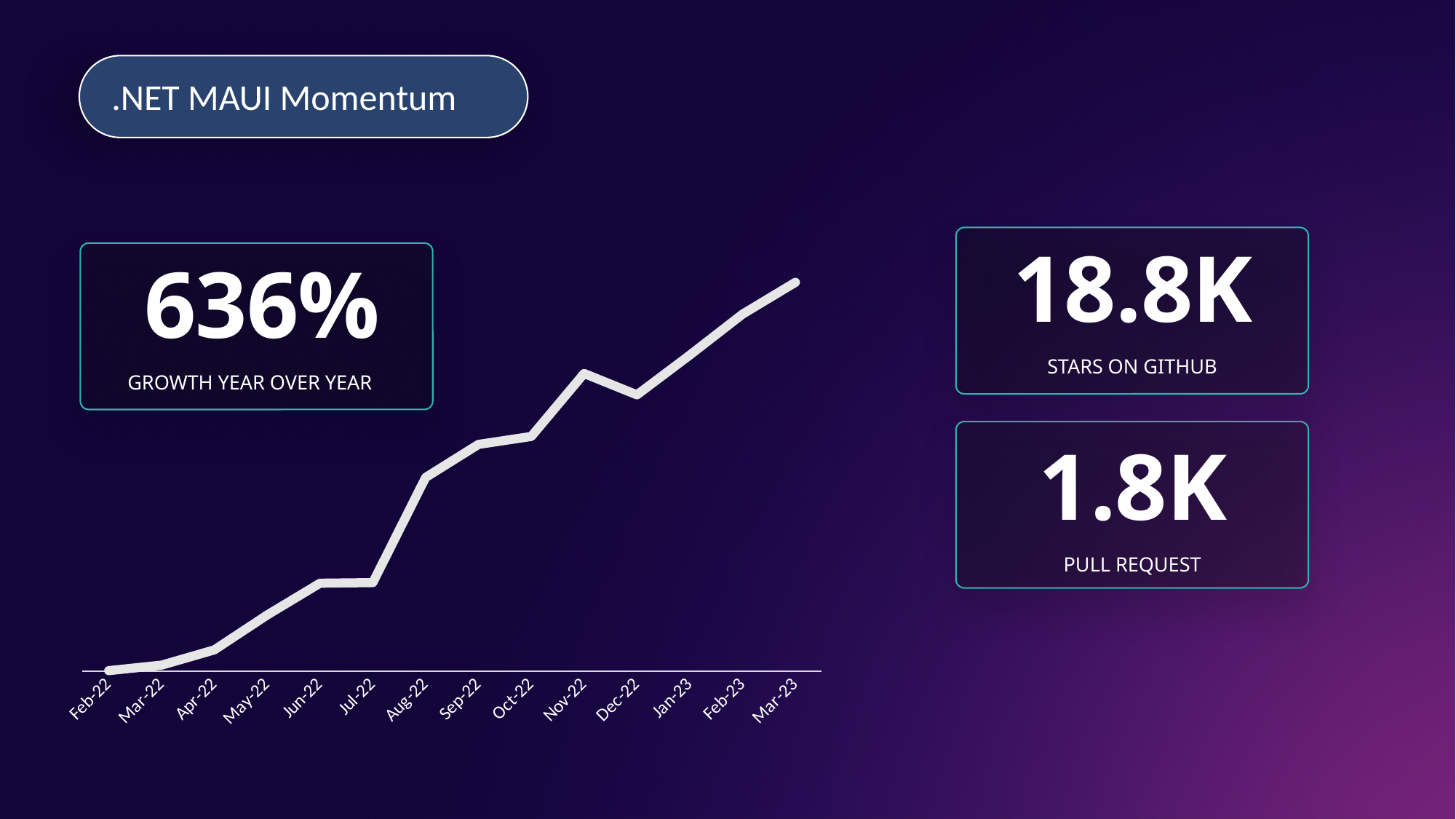
What kind of chart is shown on the slide? line chart Overall, do the values on the line chart rise or fall from Feb-22 to Mar-23? rise Which is higher on the line chart, Nov-22 or Dec-22? Nov-22 Which month has the highest value on the line chart? Mar-23 Between Nov-22 and Dec-22, does the line rise or fall? fall What is the title shown at the top of the slide? .NET MAUI Momentum Which month has the lowest value on the line chart? Feb-22 Which is higher on the line chart, Oct-22 or Jan-23? Jan-23 What is the first month labelled on the x axis of the line chart? Feb-22 How many months are labelled on the x axis of the line chart? 14 Which is higher on the line chart, Jun-22 or Aug-22? Aug-22